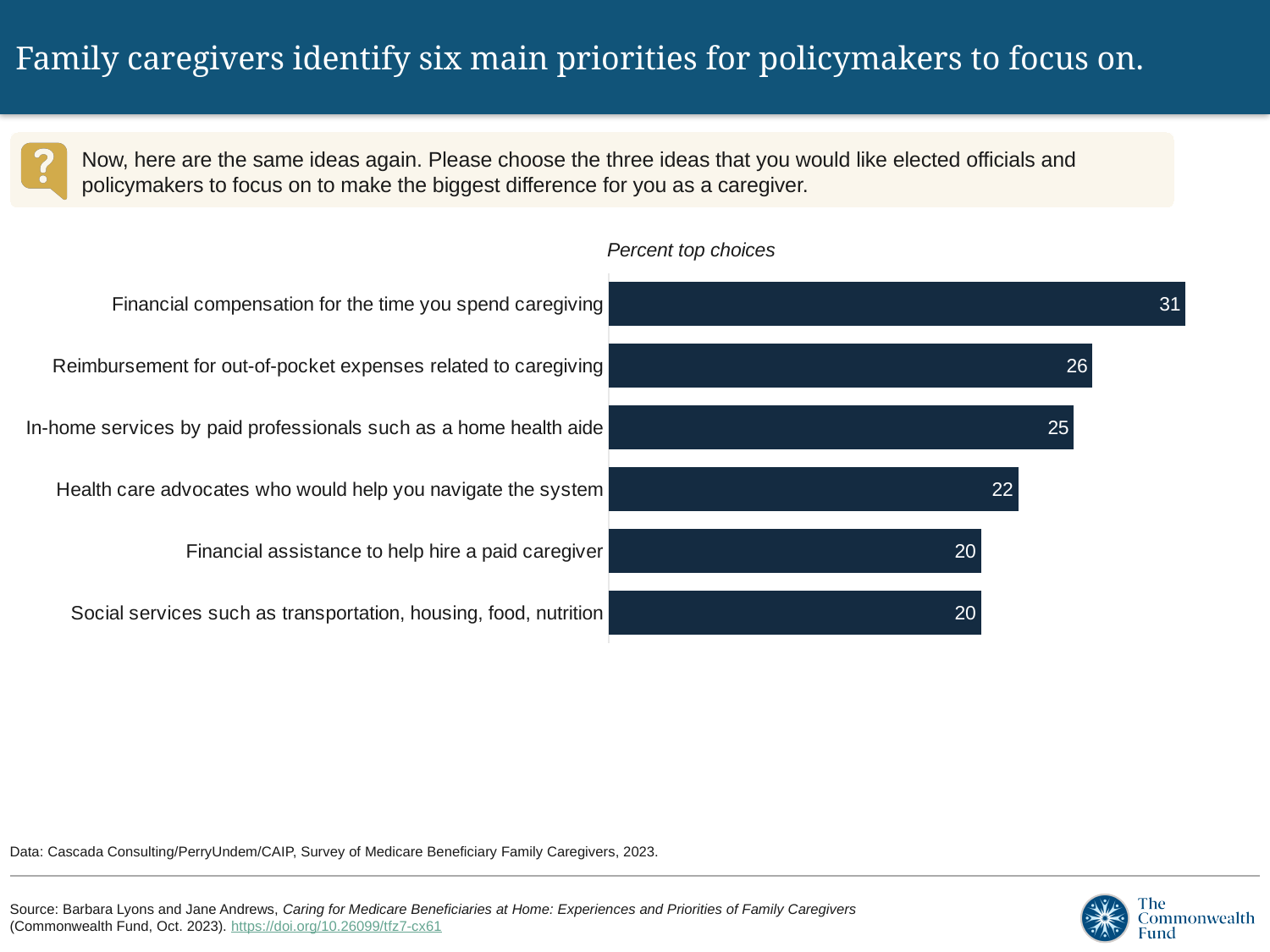
What is the value for "Health care advocates who would help you navigate the system"? 22 How many categories are shown in the chart? 6 What is the value for "Reimbursement for out-of-pocket expenses related to caregiving"? 26 Which category has the highest value? Financial compensation for the time you spend caregiving What kind of chart is shown on the slide? Bar chart What is the title shown above the chart? Percent top choices What is the difference between the values for "Health care advocates who would help you navigate the system" and "Financial assistance to help hire a paid caregiver"? 2 What is the value for "Financial compensation for the time you spend caregiving"? 31 What is the value for "In-home services by paid professionals such as a home health aide"? 25 Which is larger: the value for "In-home services by paid professionals such as a home health aide" or the value for "Health care advocates who would help you navigate the system"? In-home services by paid professionals such as a home health aide What is the difference between the values for "Financial compensation for the time you spend caregiving" and "Reimbursement for out-of-pocket expenses related to caregiving"? 5 What is the value for "Social services such as transportation, housing, food, nutrition"? 20